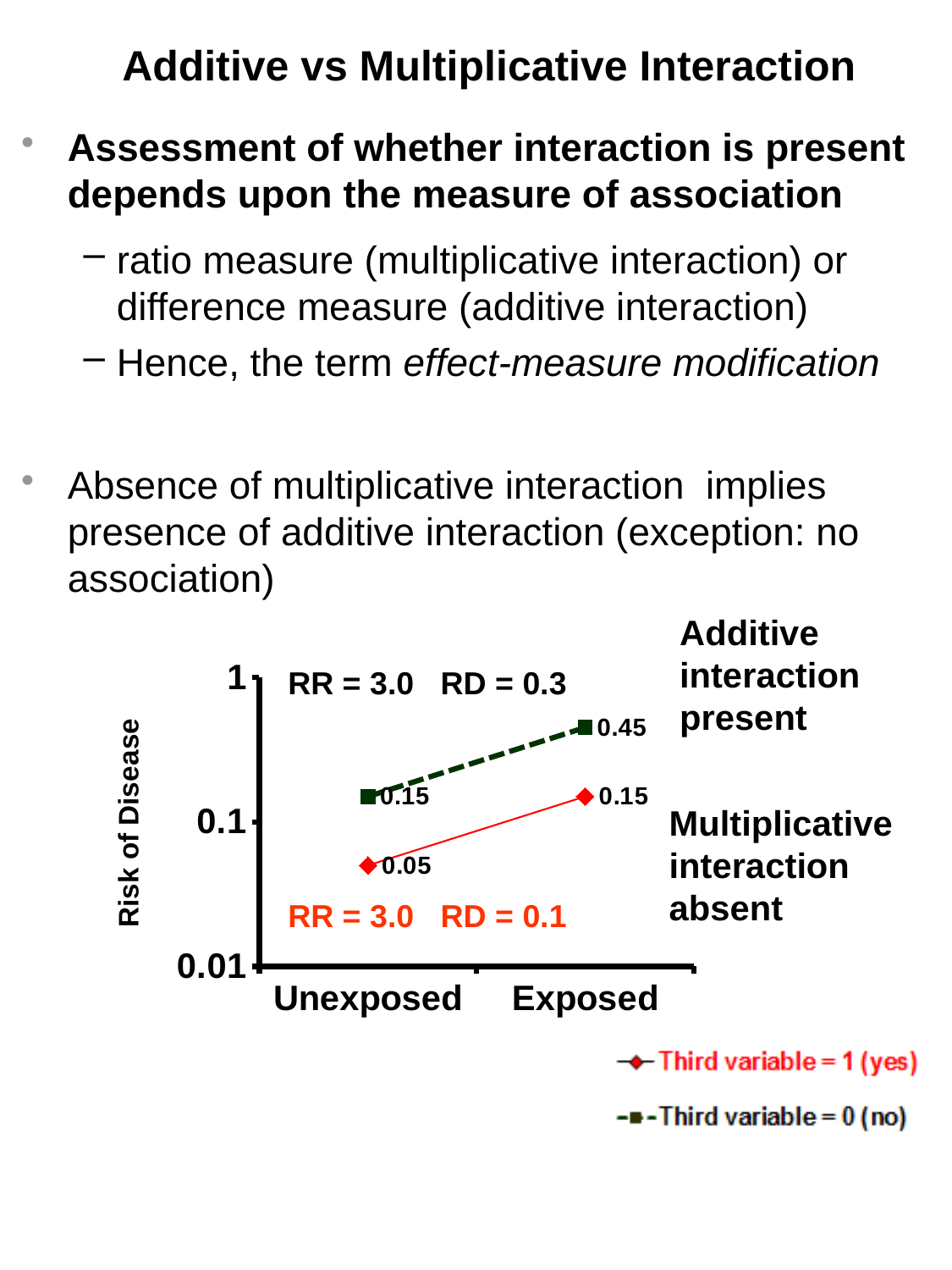
What kind of chart is shown on the slide? Line chart What is the Risk of Disease for the Exposed group in the 'Third variable = 0 (no)' series? 0.45 How many categories are shown on the x axis? 2 Does the Risk of Disease rise or fall from Unexposed to Exposed in the 'Third variable = 1 (yes)' series? Rise What is the Risk of Disease for the Exposed group in the 'Third variable = 1 (yes)' series? 0.15 Which series has the higher Risk of Disease for the Exposed group? Third variable = 0 (no) What is the difference in Risk of Disease between Exposed and Unexposed in the 'Third variable = 1 (yes)' series? 0.1 What is the Risk of Disease for the Unexposed group in the 'Third variable = 1 (yes)' series? 0.05 How many series does the legend list? 2 What is the label of the y axis? Risk of Disease What is the difference in Risk of Disease between Exposed and Unexposed in the 'Third variable = 0 (no)' series? 0.3 What is the Risk of Disease for the Unexposed group in the 'Third variable = 0 (no)' series? 0.15